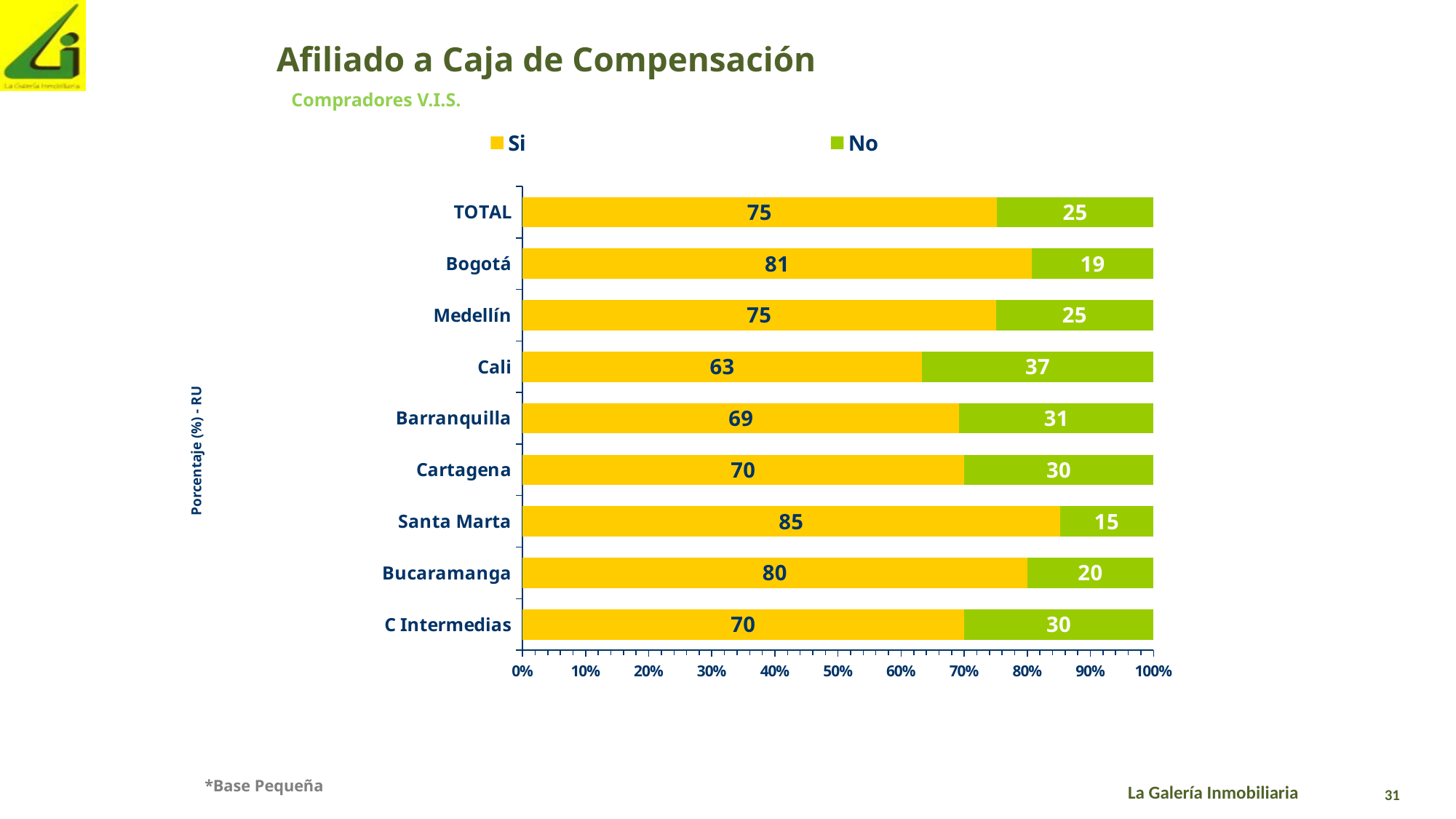
What kind of chart is shown on the slide? Stacked bar chart What is the total of the stacked bar for Medellín? 100 How many categories are shown on the chart? 9 What is the 'No' value for Cali? 37 What is the 'Si' value for Santa Marta? 85 Which category has the lowest 'Si' value? Cali What is the title of the chart? Afiliado a Caja de Compensación How many series does the legend list? 2 Which category has the highest 'Si' value? Santa Marta Which is larger, the 'No' value for Barranquilla or the 'No' value for Bucaramanga? Barranquilla What is the 'Si' value for Bogotá? 81 What is the difference between the 'Si' values for Bogotá and Cali? 18